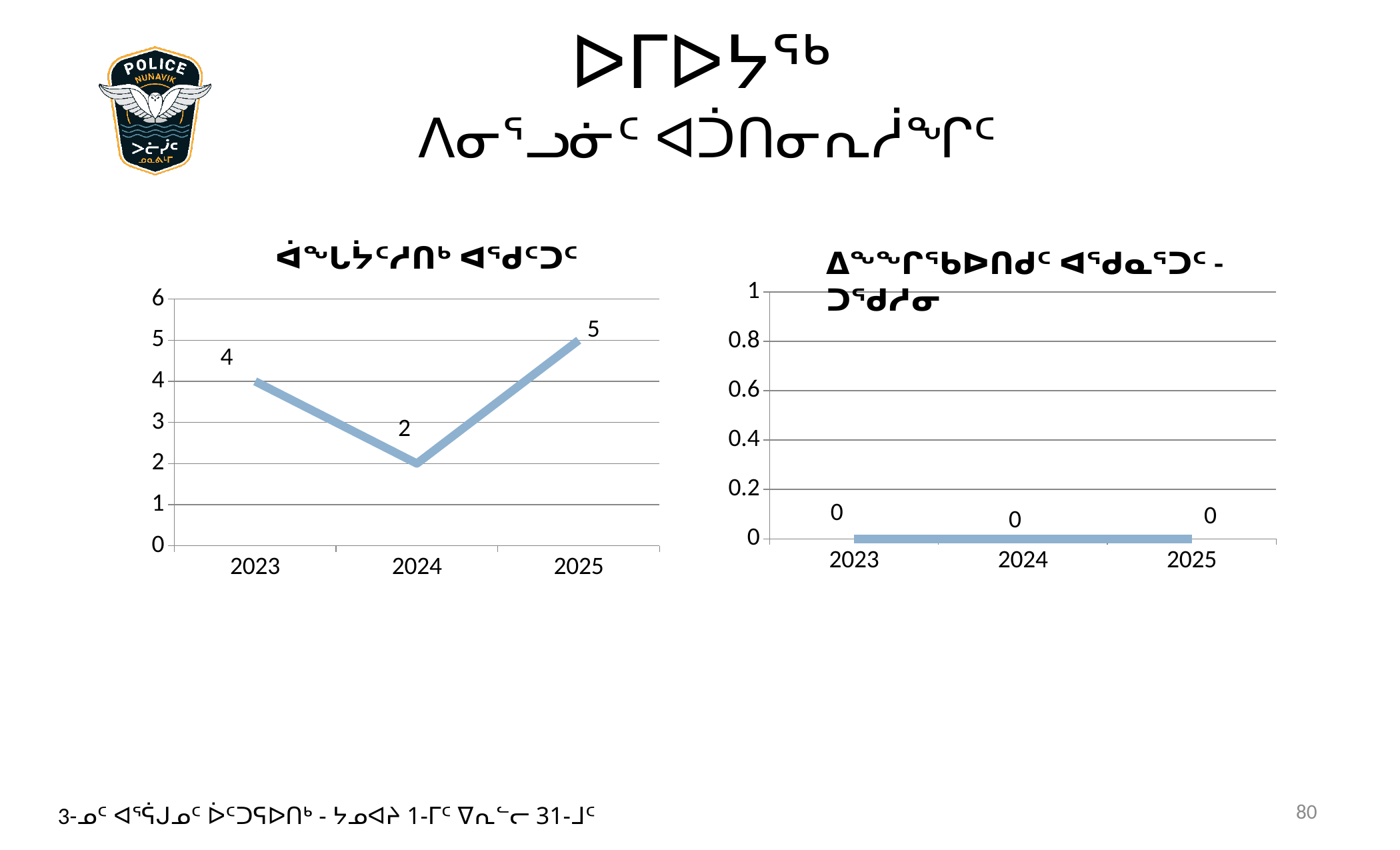
In the left chart, what is the difference between the values for 2025 and 2024? 3 In the right chart, what is the value for 2024? 0 In the left chart, which year has the highest value? 2025 In the left chart, which year has the larger value, 2023 or 2024? 2023 What kind of chart is the left chart? line chart In the left chart, how many years are plotted on the x axis? 3 In the left chart, what is the value for 2023? 4 In the left chart, what is the value for 2024? 2 In the right chart, what is the highest value shown on the y axis? 1 In the left chart, which year has the lowest value? 2024 In the left chart, does the value rise or fall from 2023 to 2024? fall In the left chart, what is the value for 2025? 5